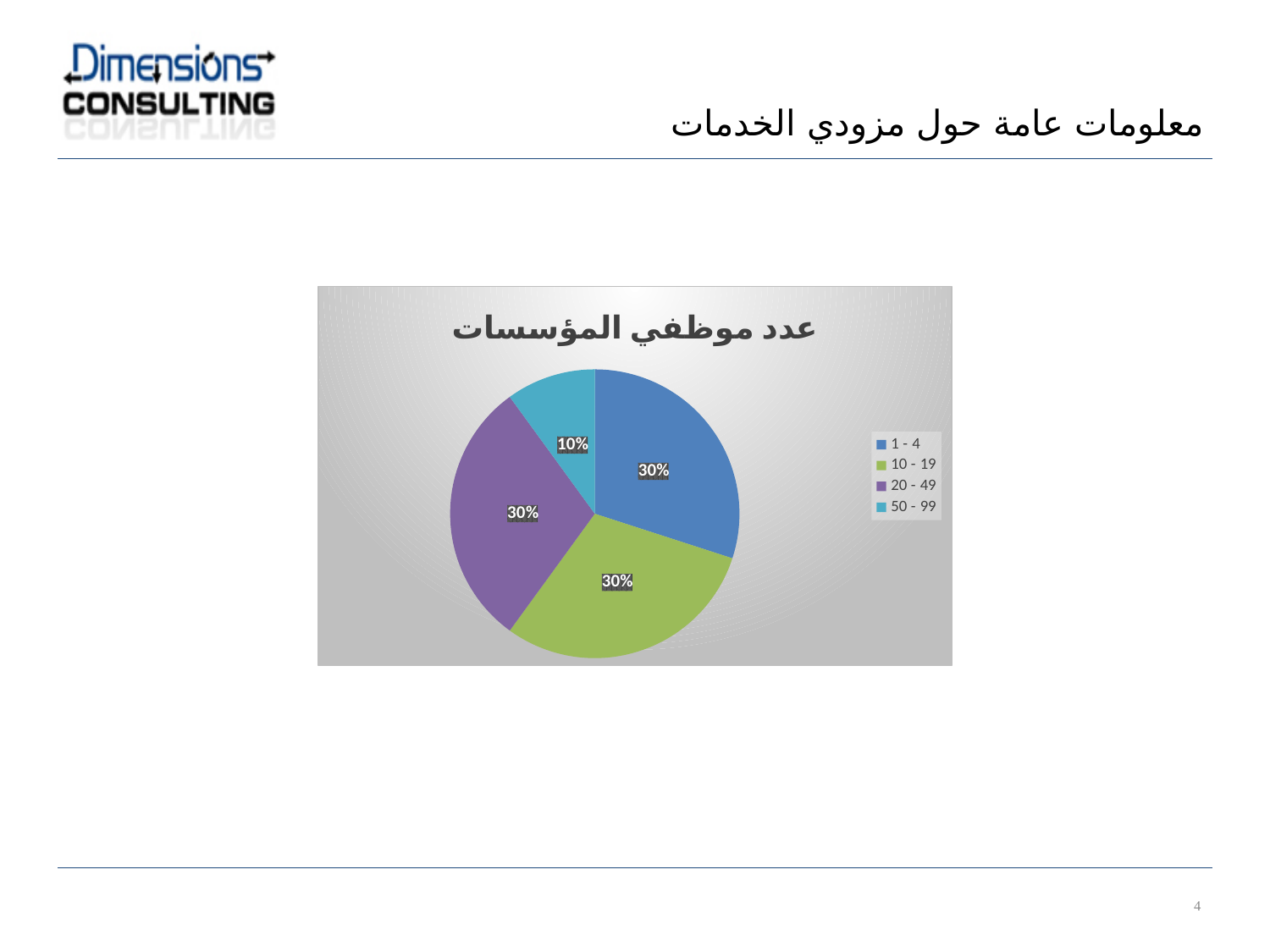
What is the difference between the share for "1 - 4" and the share for "50 - 99"? 20% What share of the pie does the "50 - 99" category have? 10% What kind of chart is shown on the slide? pie chart Which is larger, the share for "20 - 49" or the share for "50 - 99"? 20 - 49 What share of the pie does the "20 - 49" category have? 30% How many slices does the pie chart have? 4 How many entries does the legend list? 4 What share of the pie does the "10 - 19" category have? 30% What colour is the slice for the "50 - 99" category? light blue (teal) What is the title of the chart? عدد موظفي المؤسسات Which category has the smallest slice of the pie? 50 - 99